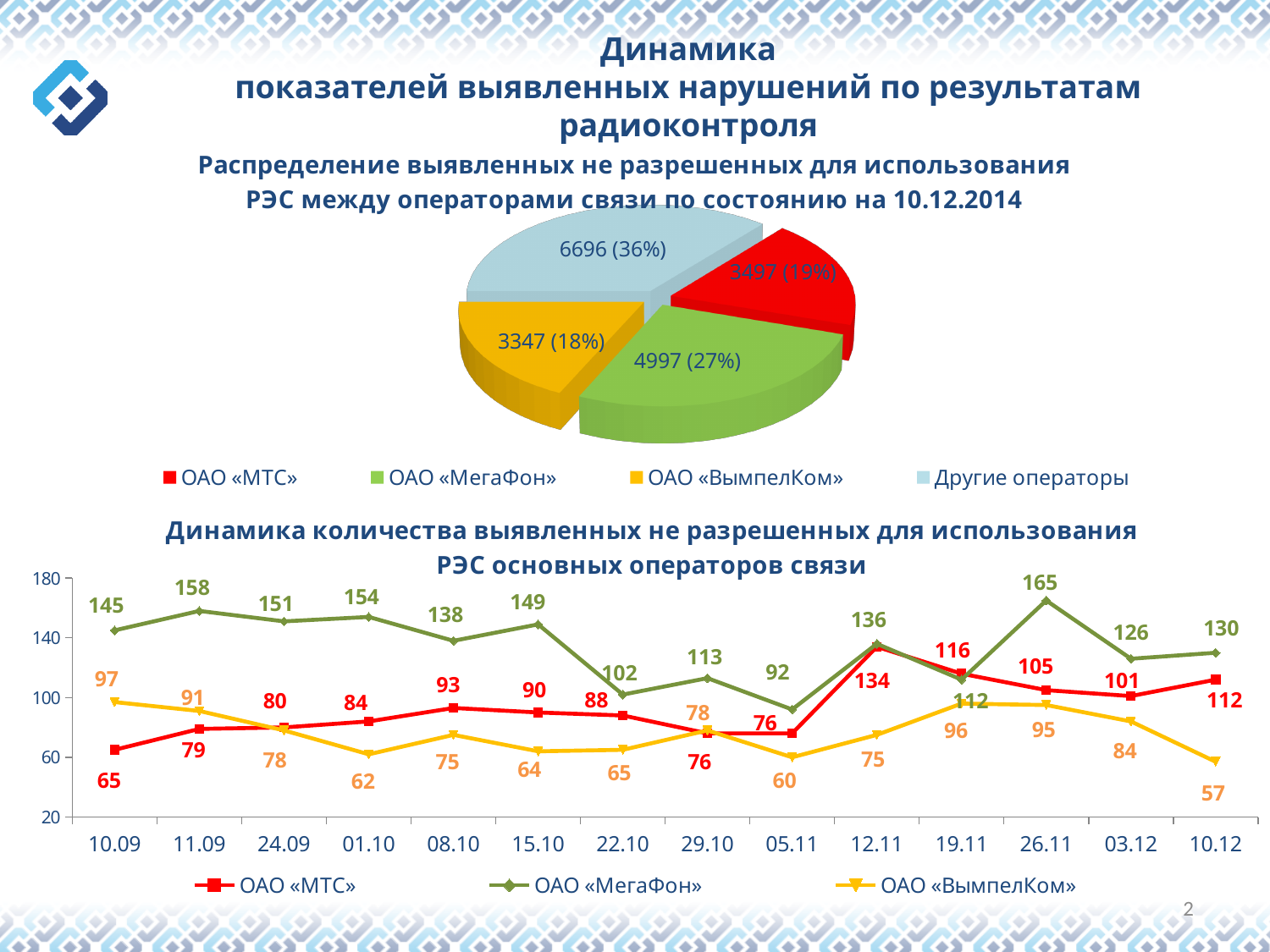
In the pie chart, what percentage share does ОАО «ВымпелКом» have? 18% In the pie chart, what value is shown for ОАО «МегаФон»? 4997 (27%) In the line chart at the bottom, what is the value for ОАО «ВымпелКом» on 10.12? 57 In the line chart at the bottom, which is larger on 19.11: ОАО «МТС» or ОАО «МегаФон»? ОАО «МТС» In the line chart at the bottom, what is the value for ОАО «МТС» on 12.11? 134 In the line chart at the bottom, on which date does ОАО «МегаФон» reach its highest value? 26.11 In the line chart at the bottom, what is the difference between ОАО «МегаФон» and ОАО «МТС» on 10.09? 80 What type of chart is the bottom chart on the slide? Line chart In the line chart at the bottom, what is the lowest value for ОАО «МТС»? 65 In the line chart at the bottom, how many series does the legend list? 3 In the pie chart, which operator has the largest share? Другие операторы In the pie chart, how many categories does the legend list? 4